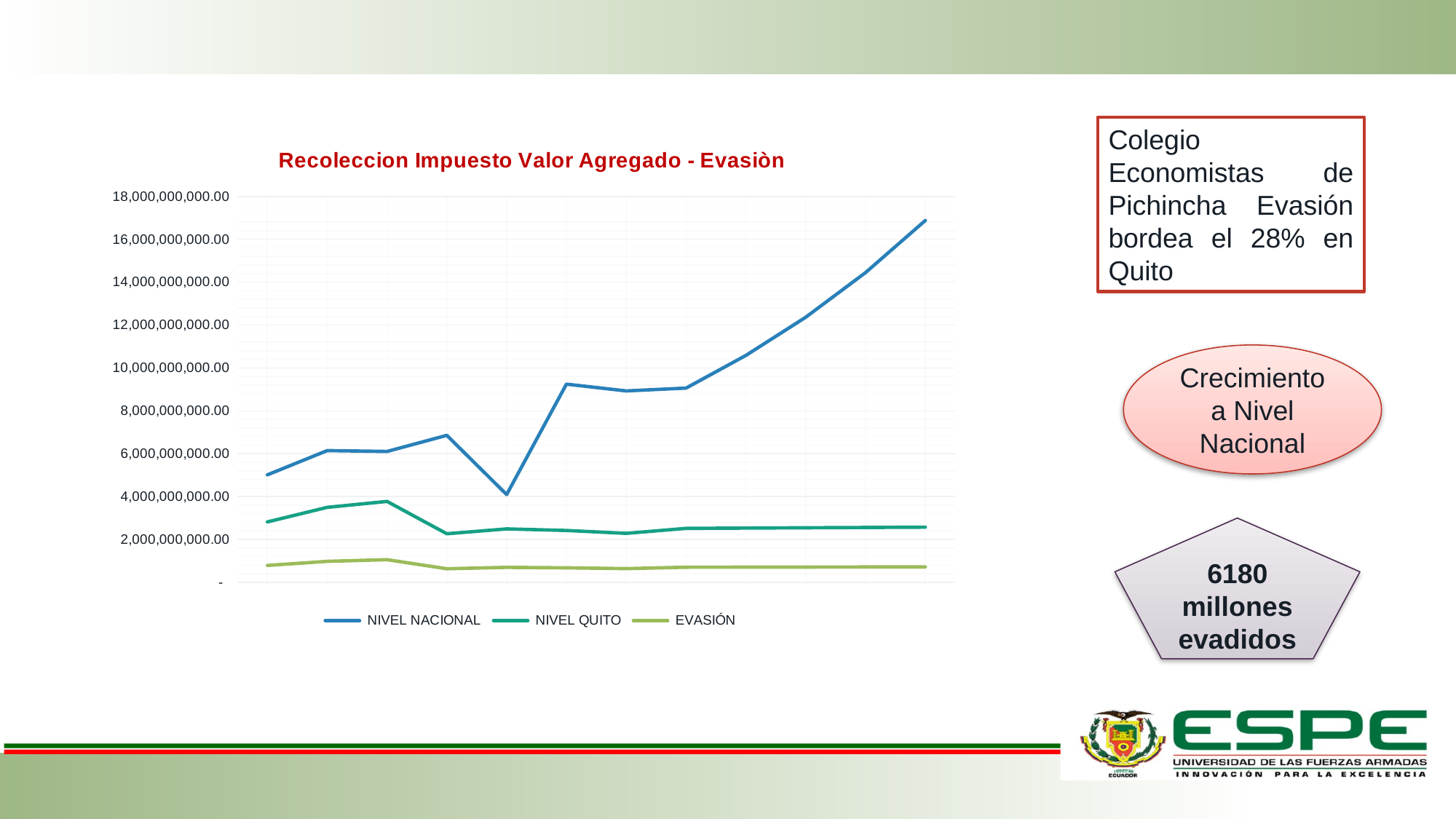
Which series has the lowest values throughout the chart? EVASIÓN How many series does the legend of the chart list? 3 Is the highest value of NIVEL QUITO greater or less than 6,000,000,000.00? less What kind of chart is shown on the slide? line chart Overall, does the NIVEL NACIONAL line rise or fall from left to right? rise What is the title of the chart? Recoleccion Impuesto Valor Agregado - Evasiòn Is the first (leftmost) value of NIVEL NACIONAL greater or less than 4,000,000,000.00? greater Is the lowest point of the NIVEL NACIONAL line greater or less than 6,000,000,000.00? less Which series has the highest values throughout the chart? NIVEL NACIONAL Which series in the legend is drawn in blue? NIVEL NACIONAL